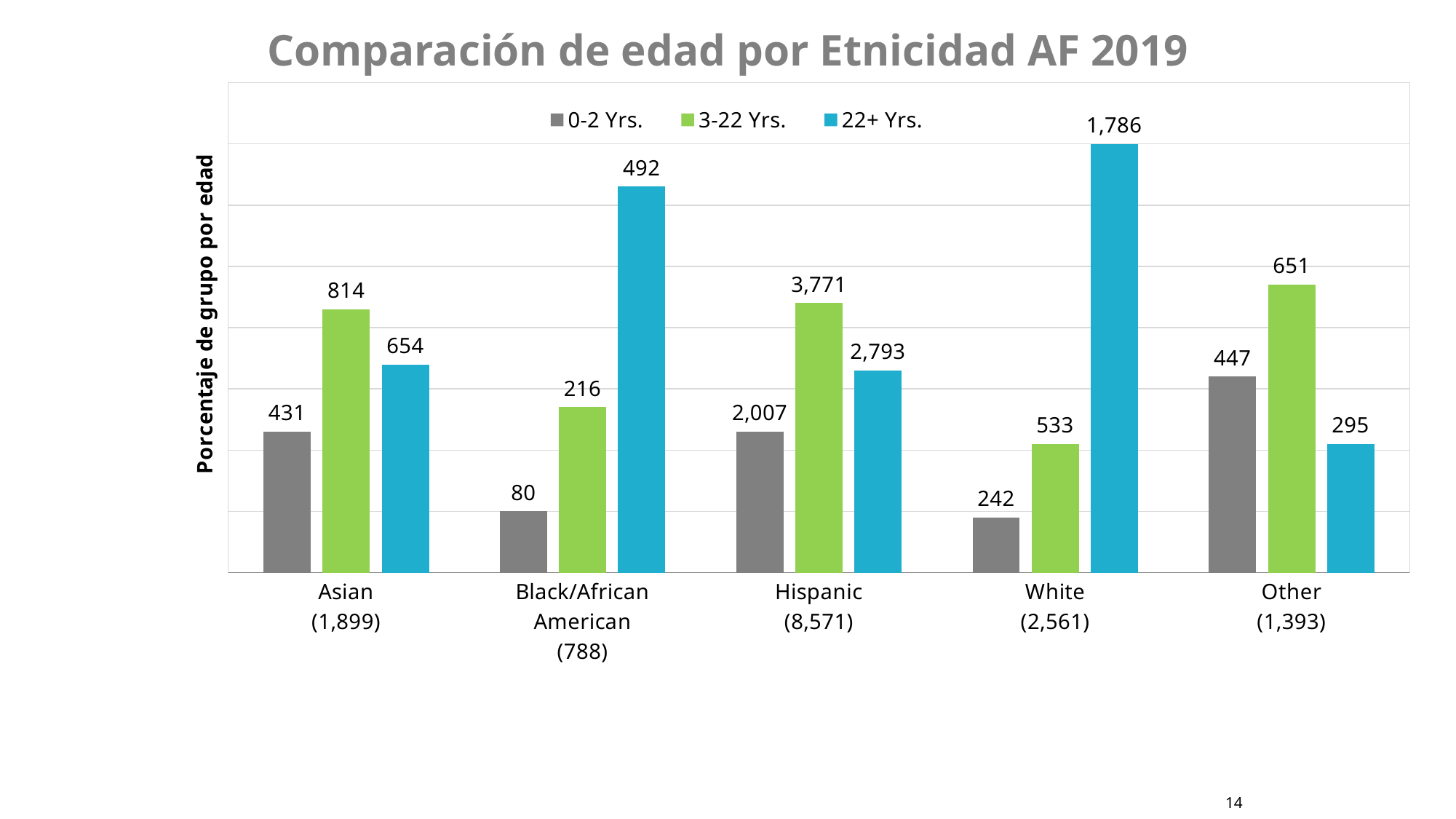
What is the data label for the 0-2 Yrs. bar for Asian? 431 How many series does the legend list? 3 What is the data label for the 3-22 Yrs. bar for White? 533 What is the data label for the 22+ Yrs. bar for White? 1,786 What is the title of the chart? Comparación de edad por Etnicidad AF 2019 What is the data label for the 22+ Yrs. bar for Other? 295 What is the difference between the 3-22 Yrs. label for Asian (814) and the 22+ Yrs. label for Asian (654)? 160 What is the data label for the 3-22 Yrs. bar for Hispanic? 3,771 What is the data label for the 0-2 Yrs. bar for Black/African American? 80 What is the difference between the 0-2 Yrs. label for Hispanic (2,007) and the 0-2 Yrs. label for White (242)? 1,765 How many ethnicity categories are shown on the x axis? 5 What kind of chart is shown on the slide? Bar chart